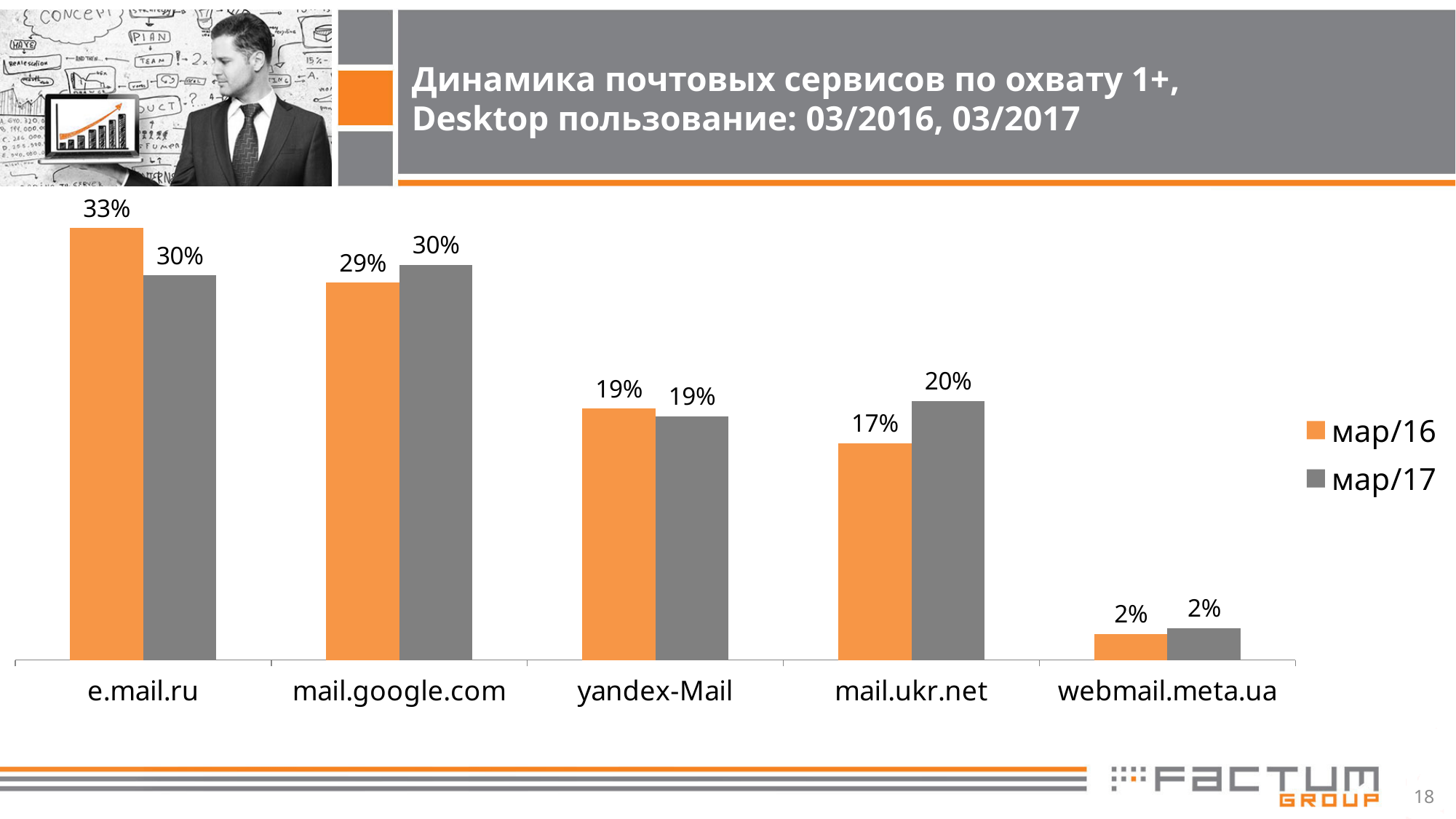
What is the value for e.mail.ru in the мар/16 series? 33% What is the value for mail.google.com in the мар/17 series? 30% What is the value for webmail.meta.ua in the мар/17 series? 2% What is the difference between the мар/17 and мар/16 values for mail.ukr.net? 3% Which category has the lowest value in the мар/17 series? webmail.meta.ua Which is larger for mail.google.com: the мар/16 value or the мар/17 value? мар/17 Which category has the highest value in the мар/16 series? e.mail.ru What kind of chart is shown on the slide? bar chart How many categories are shown on the x axis? 5 How many series does the legend list? 2 What is the difference between the мар/16 and мар/17 values for e.mail.ru? 3% What is the value for mail.ukr.net in the мар/16 series? 17%